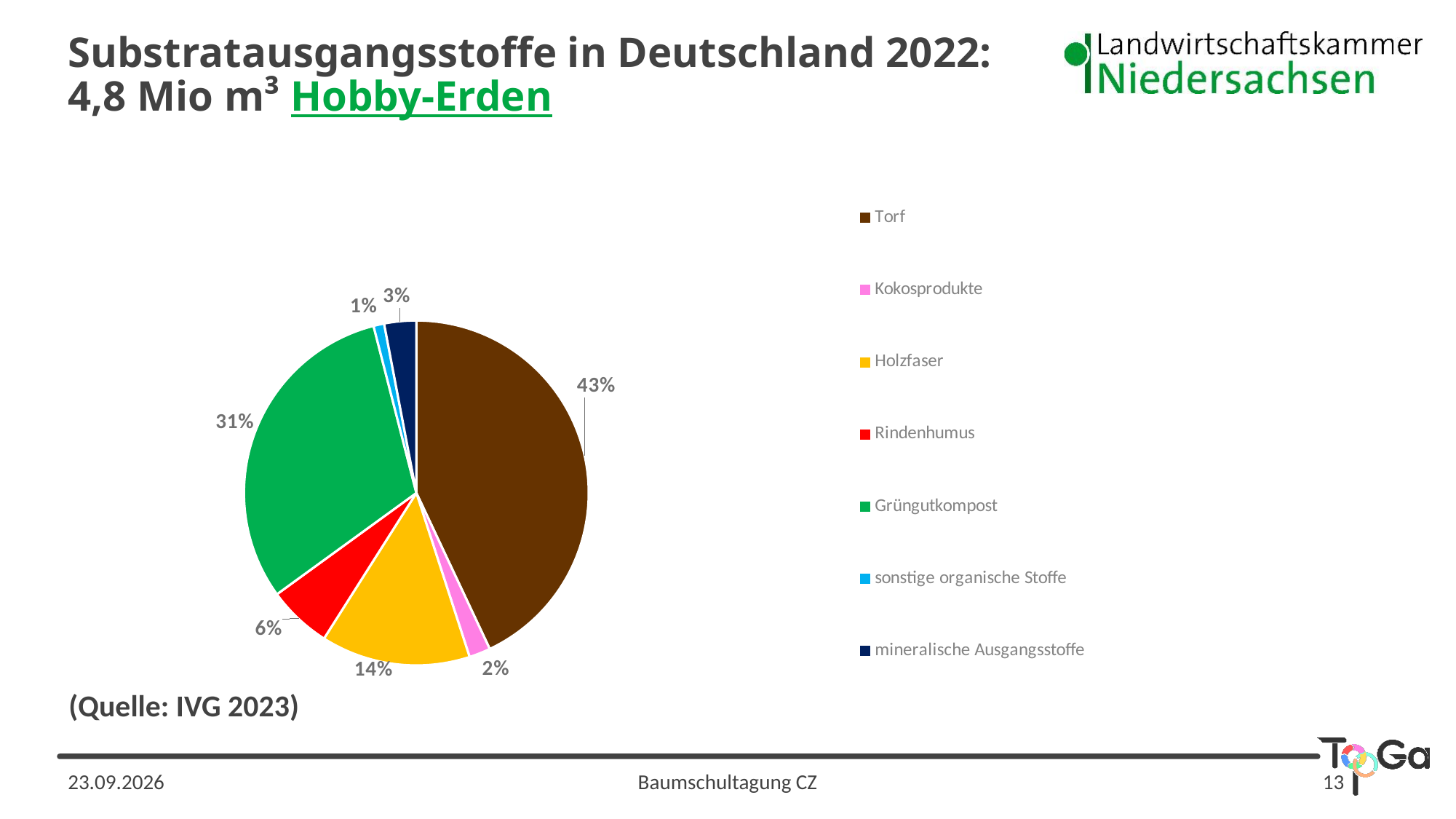
Which category has the largest slice of the pie? Torf Which slice is larger, Holzfaser or Rindenhumus? Holzfaser What share of the pie does Kokosprodukte have? 2% What kind of chart is shown on the slide? pie chart What share of the pie does Grüngutkompost have? 31% What share of the pie does Rindenhumus have? 6% How many categories does the legend list? 7 Which category has the smallest slice of the pie? sonstige organische Stoffe What is the difference in percentage points between the Torf and Grüngutkompost slices? 12 What share of the pie does Torf have? 43% What share of the pie do mineralische Ausgangsstoffe have? 3% What share of the pie does Holzfaser have? 14%